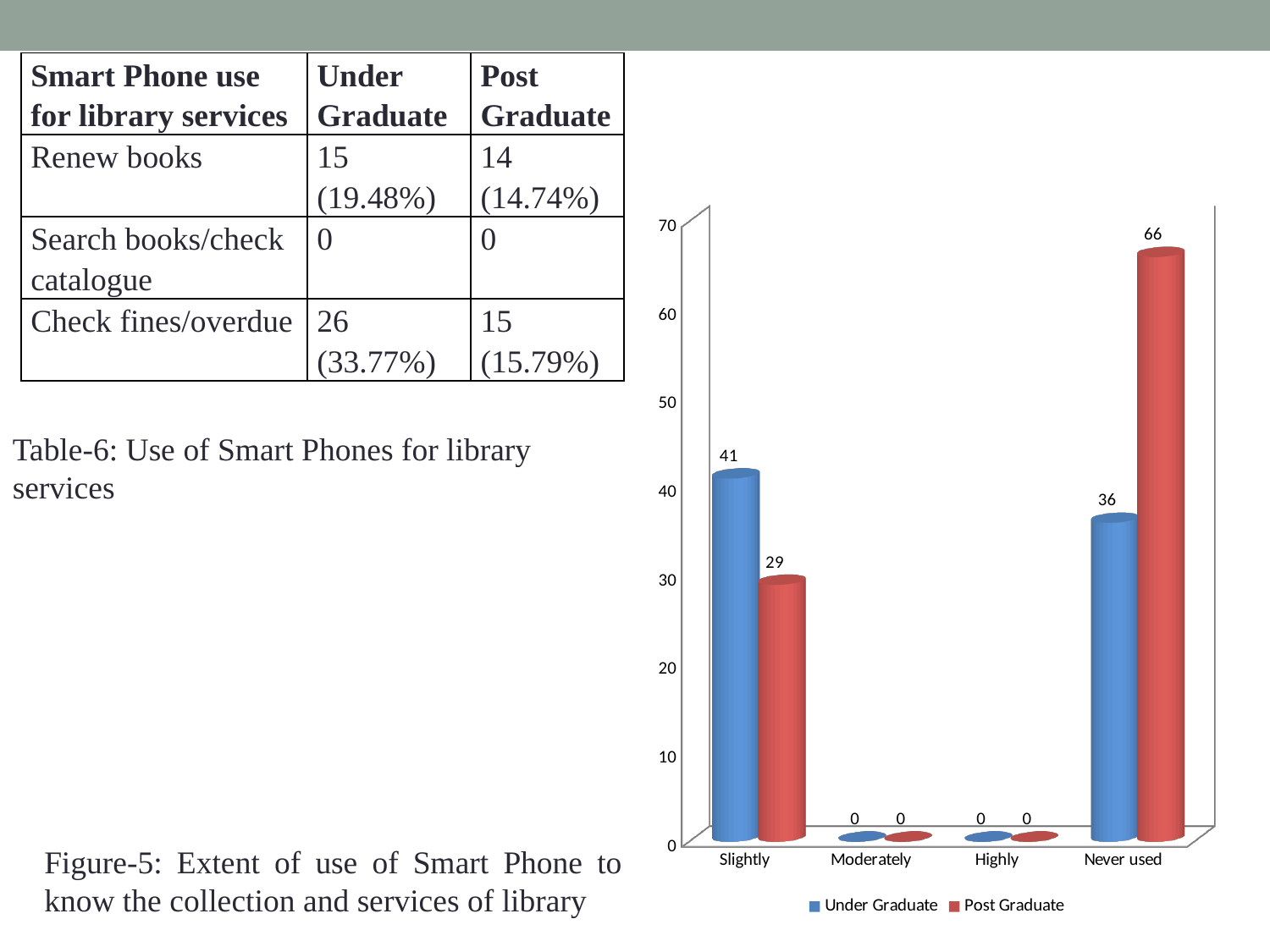
What is the value for Post Graduate in the Never used category? 66 What is the value for Under Graduate in the Slightly category? 41 What is the value for Post Graduate in the Slightly category? 29 How many categories are shown on the x axis of the chart? 4 Which category has the highest value for Post Graduate? Never used How many series does the chart legend list? 2 Which category has the highest value for Under Graduate? Slightly What is the difference between the Post Graduate and Under Graduate values in the Never used category? 30 In the Slightly category, which series has the larger value, Under Graduate or Post Graduate? Under Graduate What kind of chart is shown on the slide? Bar chart What is the value for Under Graduate in the Never used category? 36 What is the difference between the Under Graduate and Post Graduate values in the Slightly category? 12